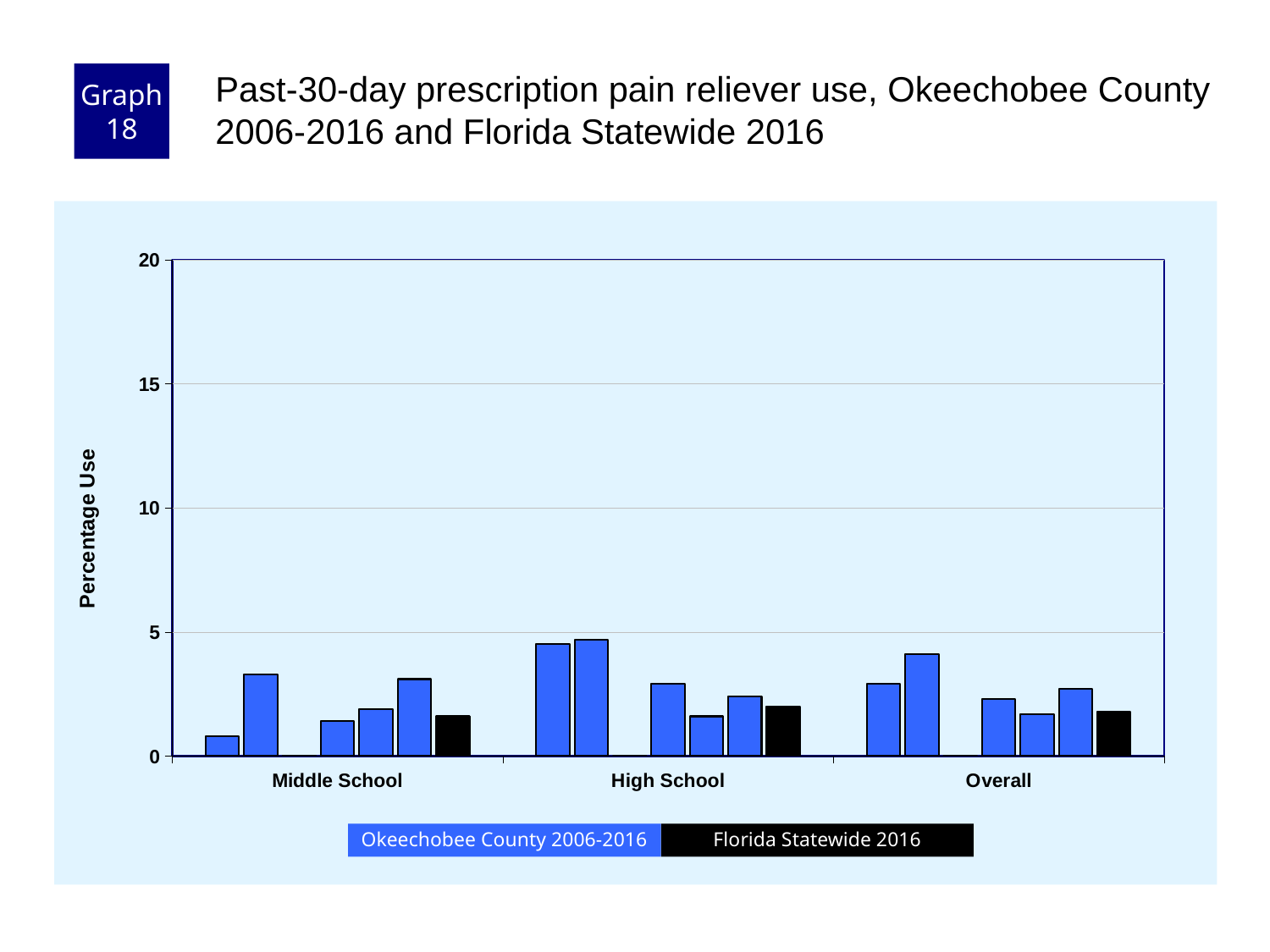
What kind of chart is shown on the slide? bar chart Which colour represents Florida Statewide 2016 in the legend? black Is the Florida Statewide 2016 value for Overall greater or less than 5? less What is the highest value shown on the y axis? 20 Which category group contains the tallest bar on the chart? High School Is the Florida Statewide 2016 value for Middle School greater or less than 5? less How many categories are shown on the x axis? 3 What is the label of the y axis? Percentage Use Which category group contains the shortest bar on the chart? Middle School How many series does the legend list? 2 Is the tallest bar in the High School group greater or less than 10? less In the High School group, which is larger: the first Okeechobee County bar or the Florida Statewide 2016 bar? the first Okeechobee County bar